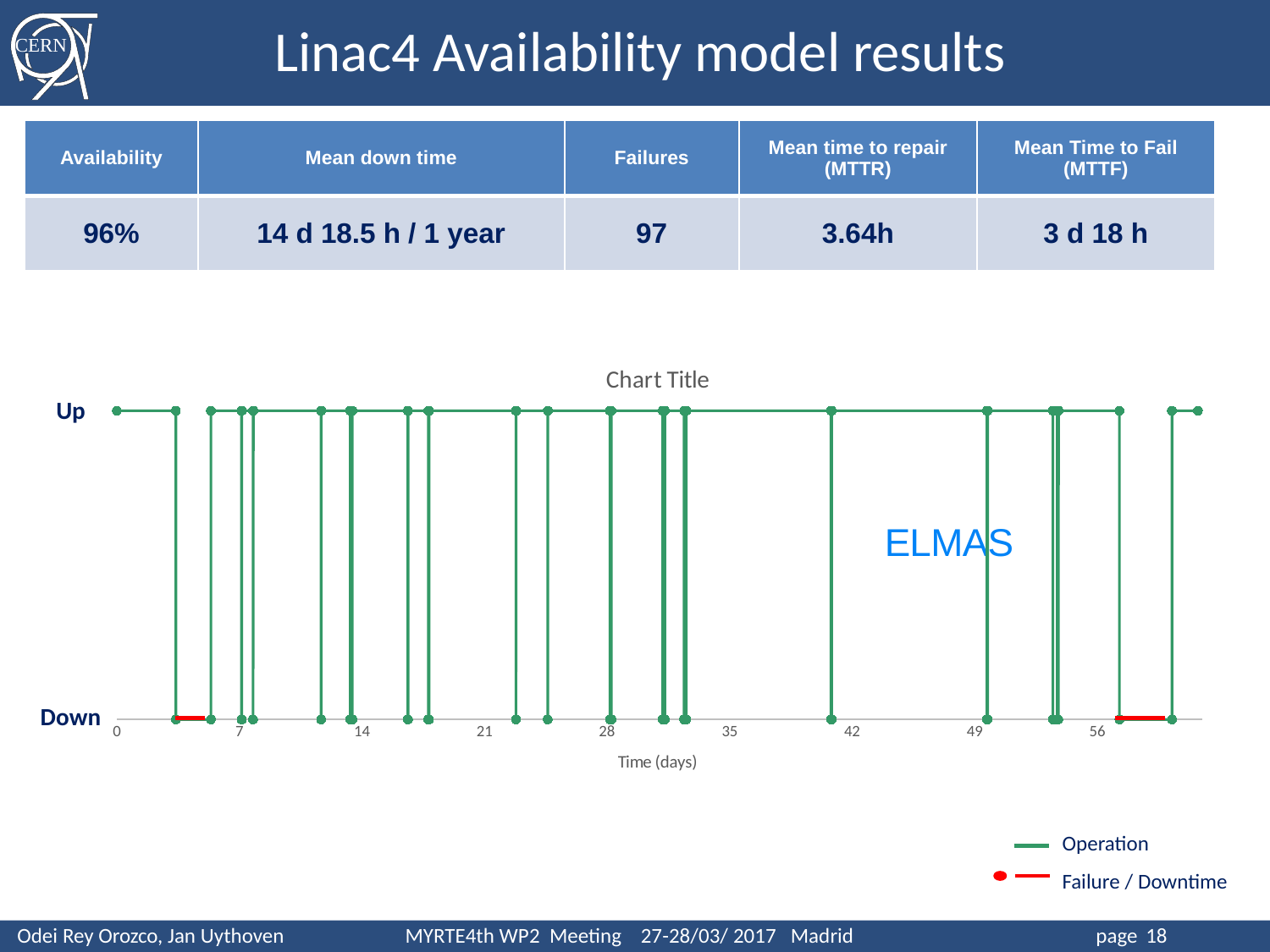
What is the largest tick label shown on the chart's x axis? 56 How many series does the chart legend list? 2 What kind of chart is shown on the slide? line chart What are the two series named in the chart legend? Operation and Failure / Downtime What is the title of the chart's x axis? Time (days) How many tick labels are shown along the chart's x axis? 9